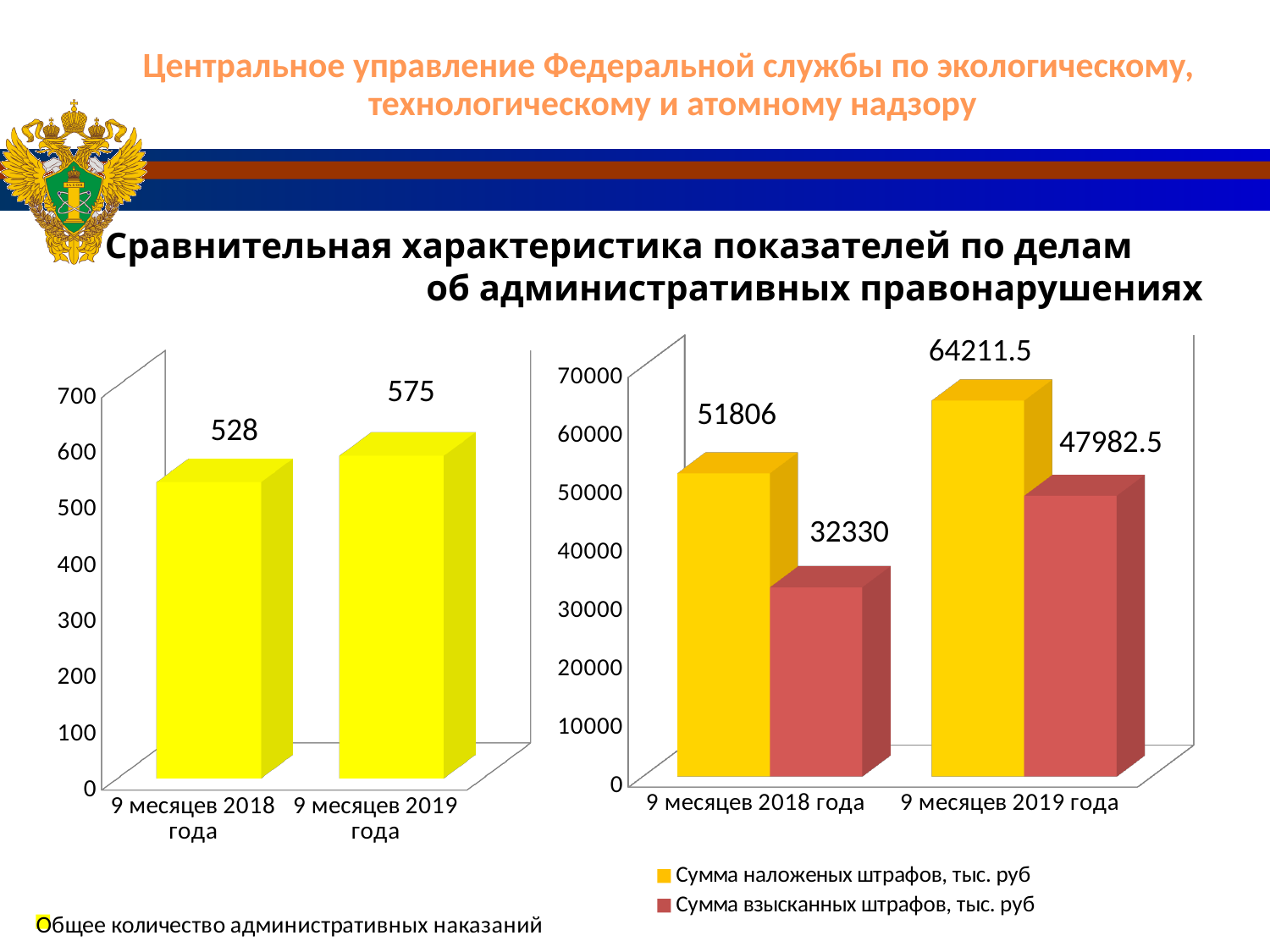
In the right chart, what is the value of Сумма наложеных штрафов for 9 месяцев 2019 года? 64211.5 In the left chart, what is the value for 9 месяцев 2019 года? 575 In the right chart, which category has the lowest value of Сумма взысканных штрафов? 9 месяцев 2018 года In the right chart, what is the value of Сумма взысканных штрафов for 9 месяцев 2018 года? 32330 In the right chart, how many series does the legend list? 2 In the right chart, what is the difference between Сумма наложеных штрафов and Сумма взысканных штрафов for 9 месяцев 2018 года? 19476 In the right chart, which series has the higher value for 9 месяцев 2019 года: Сумма наложеных штрафов or Сумма взысканных штрафов? Сумма наложеных штрафов In the left chart, do the values rise or fall from 9 месяцев 2018 года to 9 месяцев 2019 года? rise What type of chart is the left chart? bar chart In the left chart, what is the value for 9 месяцев 2018 года? 528 In the left chart, what is the difference between the values for 9 месяцев 2019 года and 9 месяцев 2018 года? 47 In the right chart, what is the value of Сумма взысканных штрафов for 9 месяцев 2019 года? 47982.5